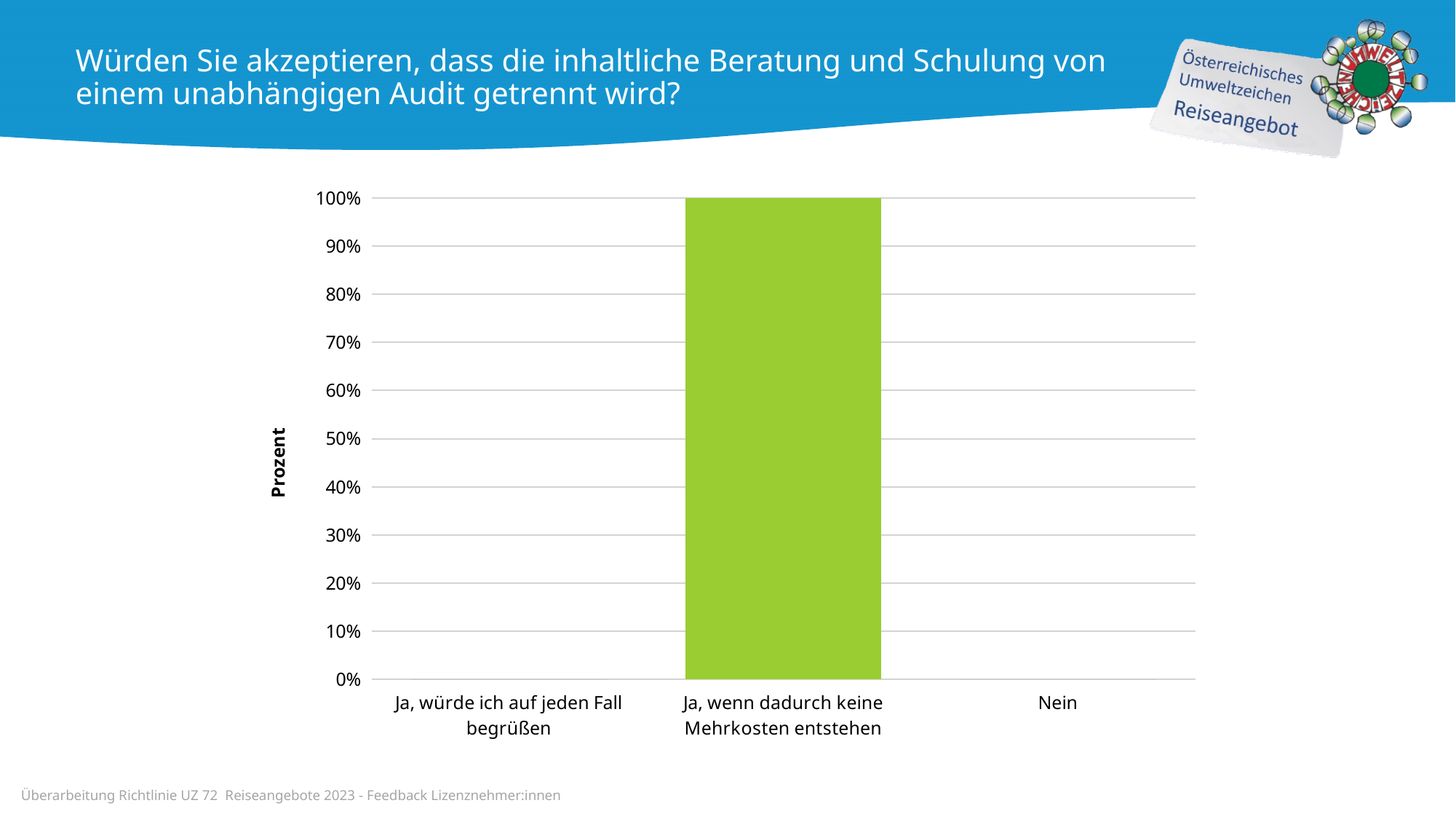
What is the value for "Ja, wenn dadurch keine Mehrkosten entstehen"? 100% What colour is the bar in the chart? green What is the highest value shown on the y axis of the chart? 100% What is the value for "Nein"? 0% How many categories are shown on the x axis of the chart? 3 What is the difference between the value for "Ja, wenn dadurch keine Mehrkosten entstehen" and the value for "Nein"? 100% What type of chart is shown on the slide? bar chart Which category has the highest value in the chart? Ja, wenn dadurch keine Mehrkosten entstehen What is the label of the y axis of the chart? Prozent Is the value for "Ja, wenn dadurch keine Mehrkosten entstehen" greater or less than 50%? greater Which is larger: the value for "Ja, wenn dadurch keine Mehrkosten entstehen" or the value for "Nein"? Ja, wenn dadurch keine Mehrkosten entstehen What is the value for "Ja, würde ich auf jeden Fall begrüßen"? 0%